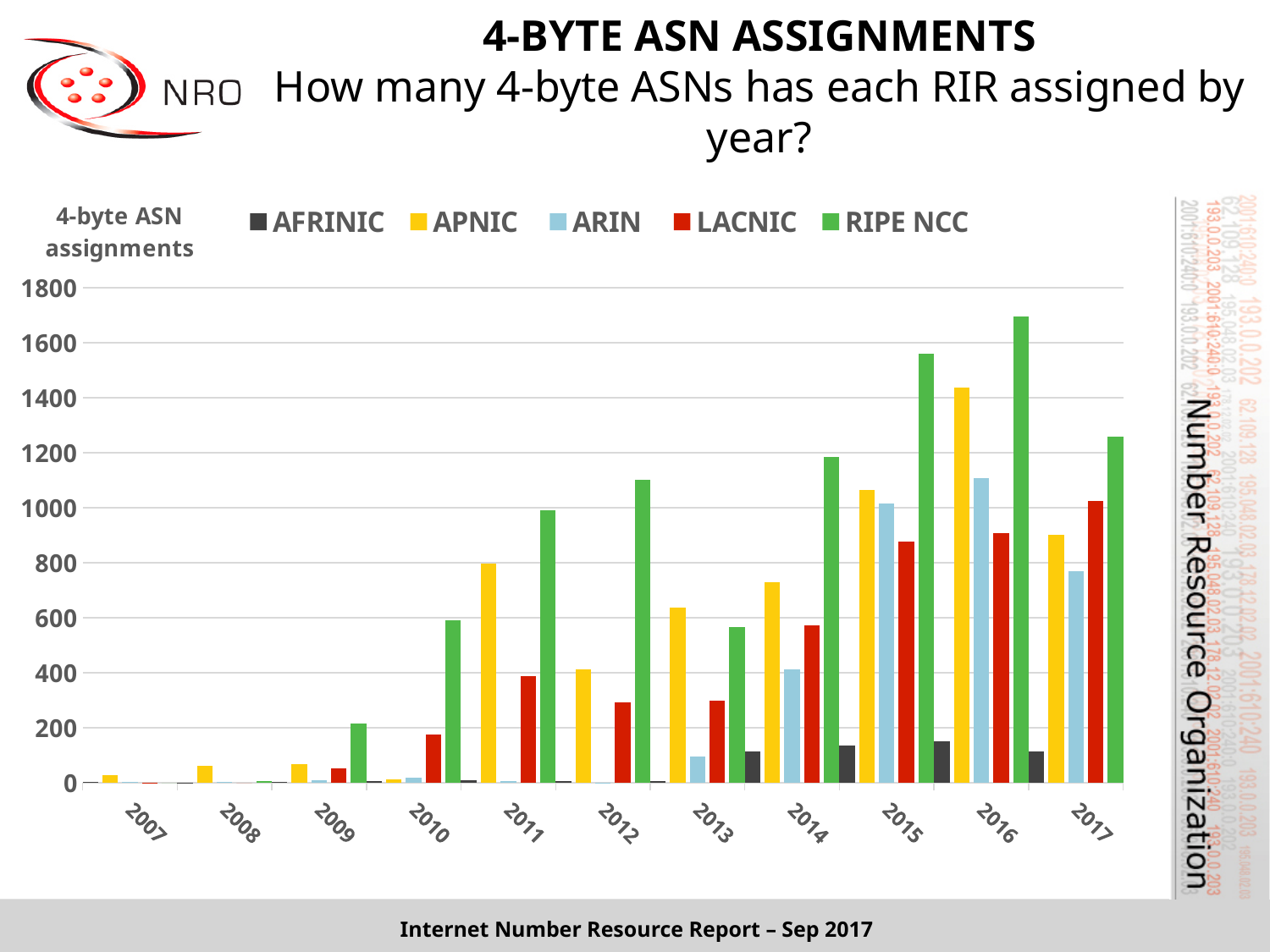
Is the value for RIPE NCC in 2016 greater or less than 1600? greater In 2017, which assigned more 4-byte ASNs, LACNIC or ARIN? LACNIC What kind of chart is shown on the slide? bar chart In which year did RIPE NCC assign the most 4-byte ASNs? 2016 How many RIRs (series) does the legend list? 5 In 2013, which assigned more 4-byte ASNs, APNIC or RIPE NCC? APNIC How many years are shown along the x axis? 11 Which RIR assigned the most 4-byte ASNs in 2017? RIPE NCC What colour represents RIPE NCC in the legend? green Is the value for ARIN in 2014 greater or less than 600? less Is the value for APNIC in 2015 greater or less than 1000? greater Which RIR assigned the fewest 4-byte ASNs in 2015? AFRINIC